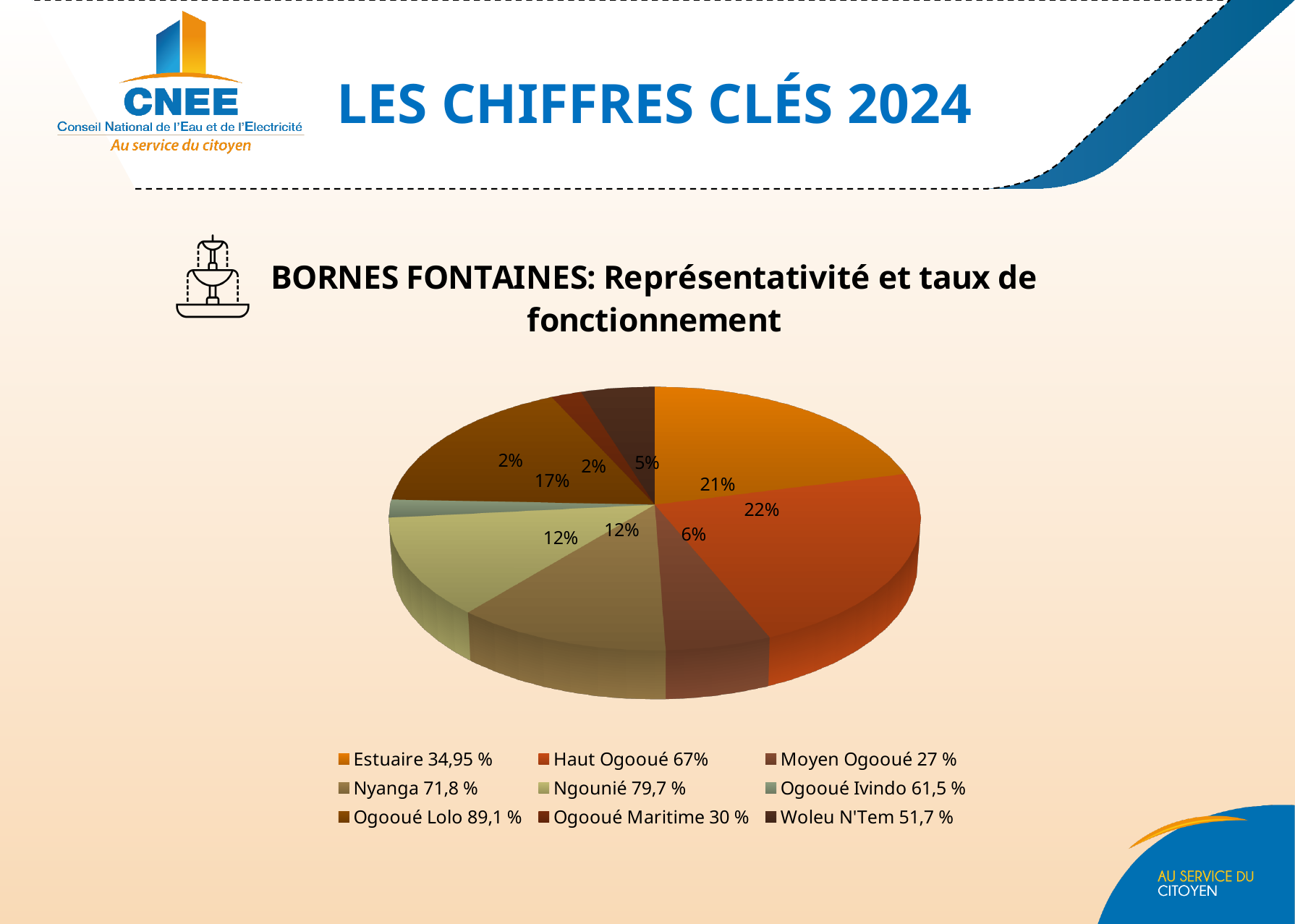
What functioning rate is shown next to Ogooué Lolo in the legend? 89,1 % What share of the pie does Haut Ogooué represent? 22% What is the difference in percentage points between the Haut Ogooué slice and the Moyen Ogooué slice? 16 What share of the pie does Moyen Ogooué represent? 6% Which province has the largest slice of the pie? Haut Ogooué What share of the pie does Estuaire represent? 21% How many slices does the pie chart have? 9 What functioning rate is shown next to Estuaire in the legend? 34,95 % What kind of chart is shown on the slide? pie chart Which slice is larger, Ogooué Lolo or Nyanga? Ogooué Lolo